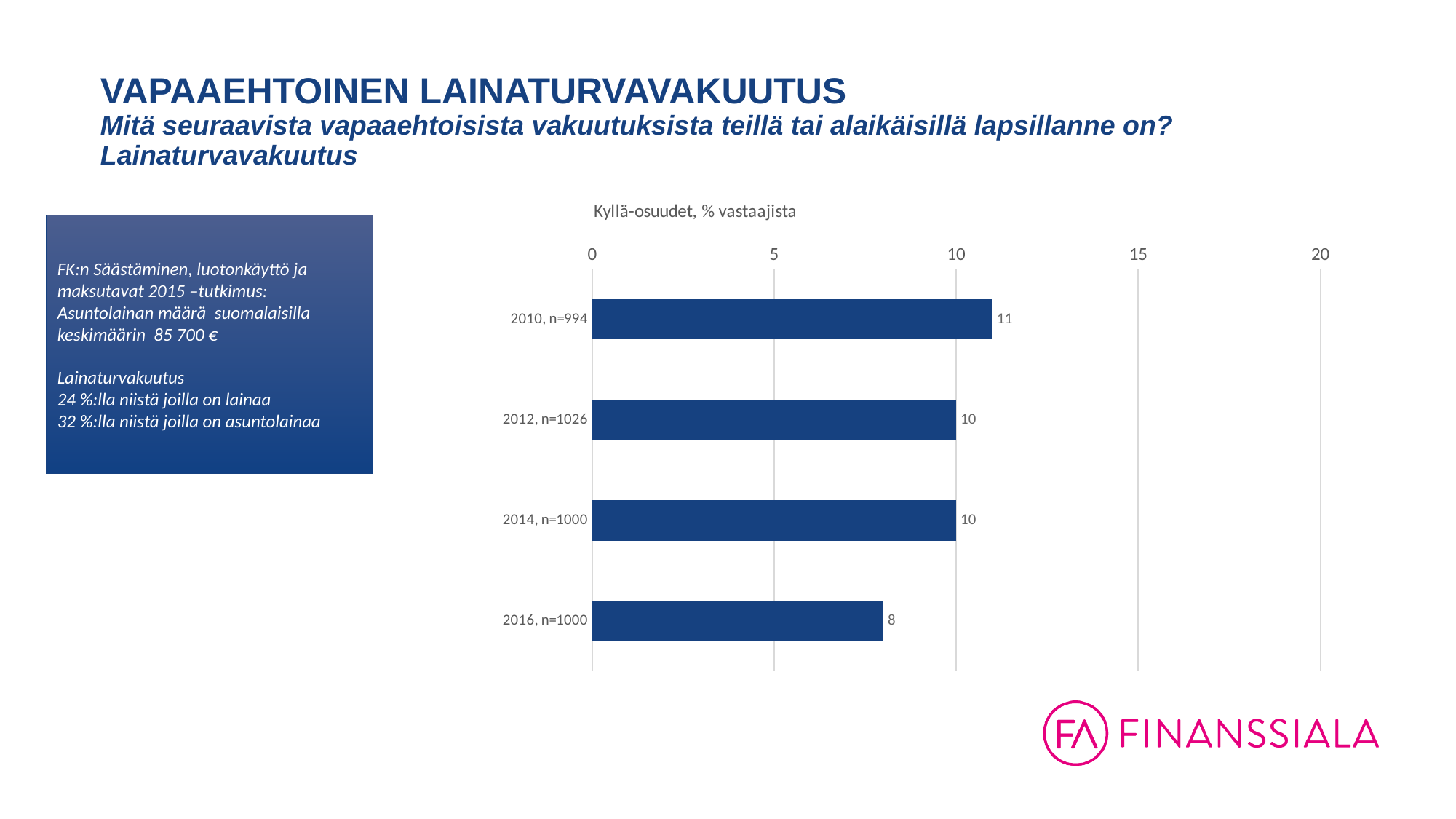
Do the values rise or fall from 2010 to 2016? fall Is the value for 2010, n=994 greater or less than 10? greater Which category has the highest value? 2010, n=994 What is the value for 2010, n=994? 11 What kind of chart is shown on the slide? bar chart What is the value for 2016, n=1000? 8 What is the value for 2012, n=1026? 10 How many categories are shown in the chart? 4 What is the difference between the values for 2010, n=994 and 2016, n=1000? 3 What is the title of the chart? Kyllä-osuudet, % vastaajista Which is larger, the value for 2014, n=1000 or the value for 2016, n=1000? 2014, n=1000 Which category has the lowest value? 2016, n=1000